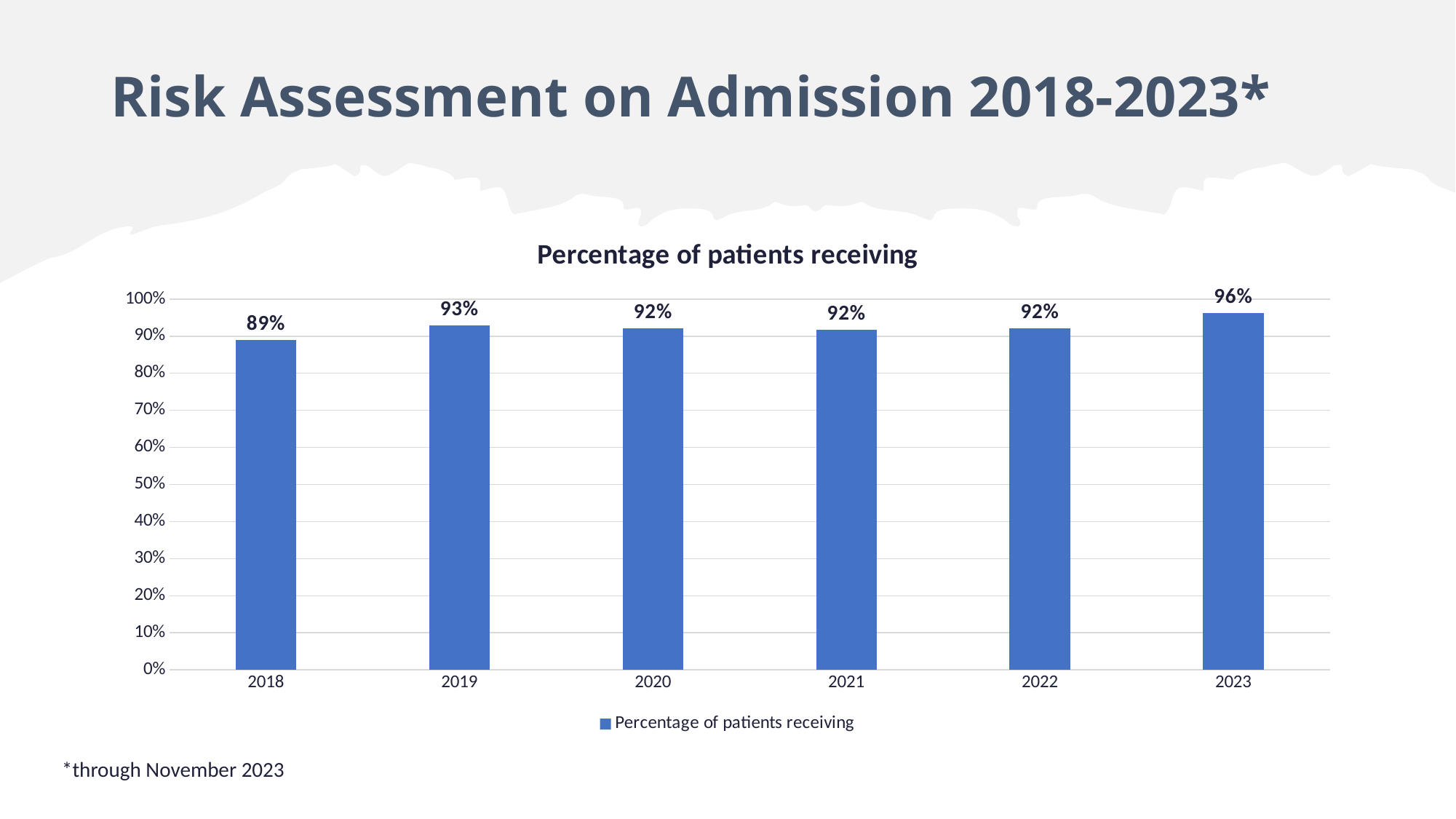
Which year has the lowest percentage of patients receiving a risk assessment? 2018 How many series does the legend list? 1 What is the value shown for 2023? 96% Is the value for 2021 greater or less than 80%? greater What is the title of the chart? Percentage of patients receiving What percentage of patients received a risk assessment on admission in 2018? 89% How many years are shown on the x axis? 6 Which is larger, the value for 2019 or the value for 2018? 2019 What is the difference between the 2023 value and the 2018 value? 7% What kind of chart is shown on the slide? bar chart Which year has the highest percentage of patients receiving a risk assessment? 2023 What is the value shown for 2019? 93%